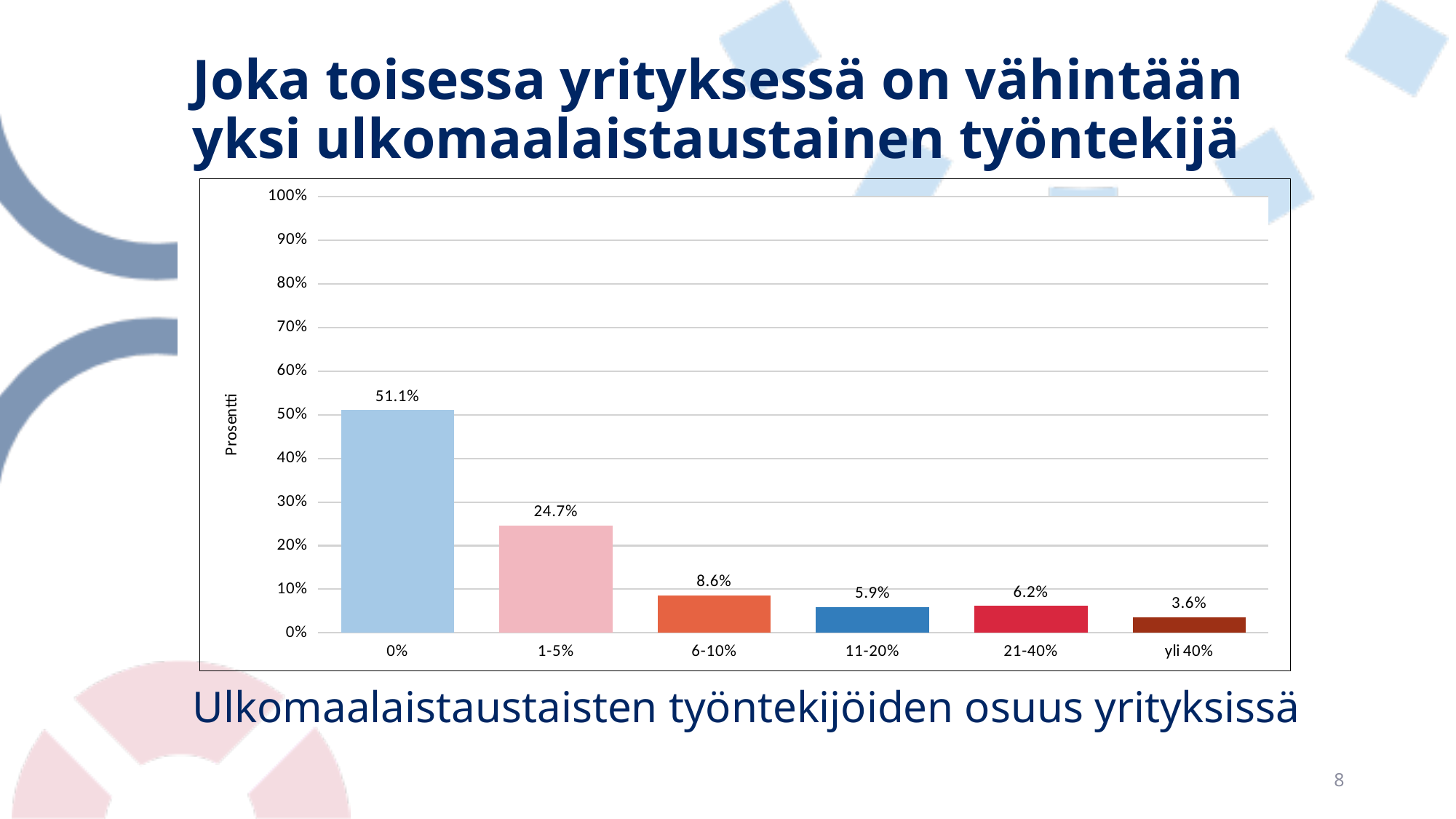
Which category has the highest value? 0% What is the value for the 0% category? 51.1% Which is larger, the value for 11-20% or the value for 21-40%? 21-40% What is the value for the 1-5% category? 24.7% How many categories are shown on the x axis? 6 Is the value for 1-5% greater or less than 20%? greater What is the value for the yli 40% category? 3.6% Which category has the lowest value? yli 40% What kind of chart is shown on the slide? Bar chart What is the difference between the values for 0% and 1-5%? 26.4% What is the value for the 6-10% category? 8.6% What is the label of the vertical axis? Prosentti